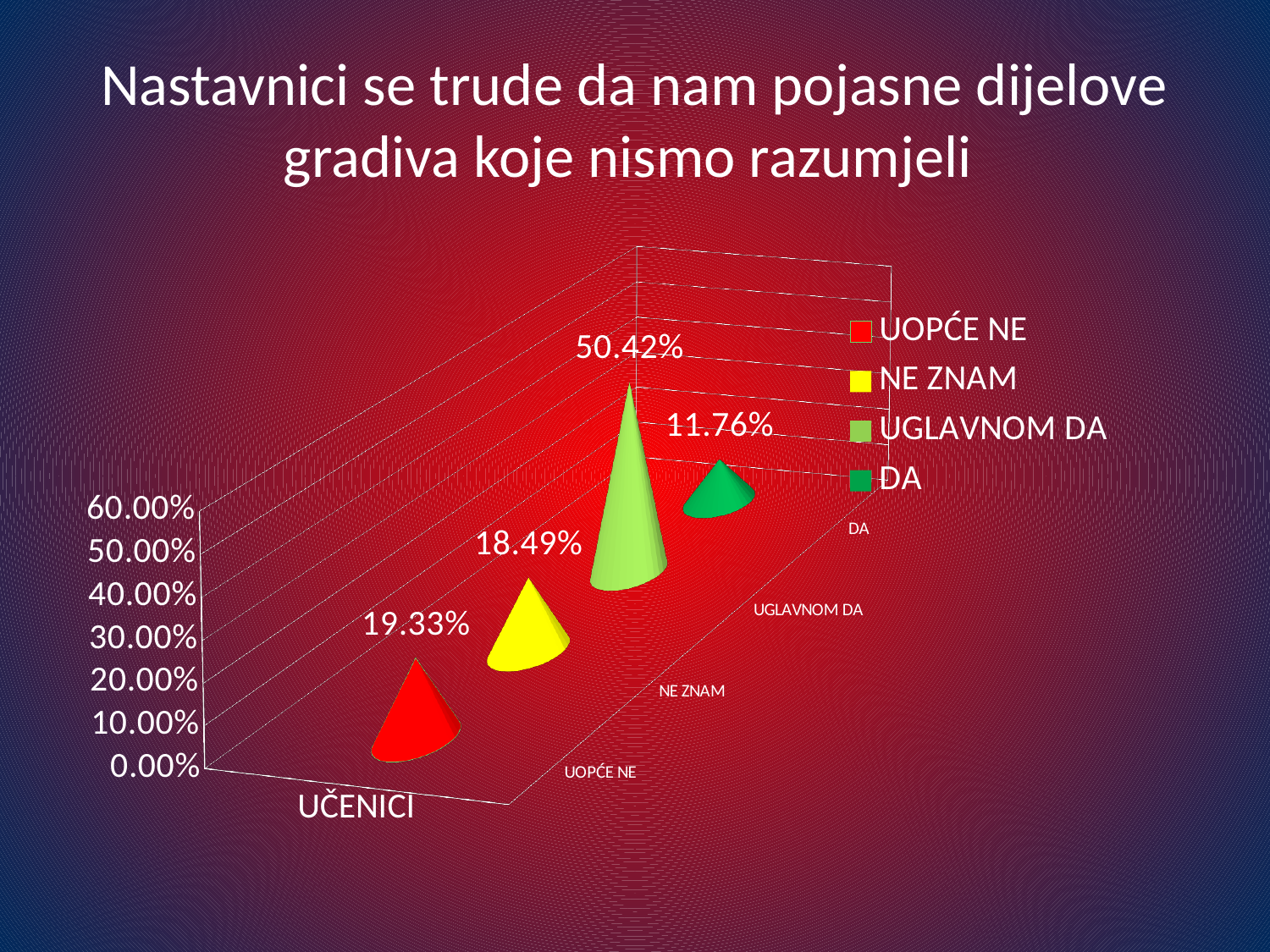
What is the value for DA? 11.76% How many series does the legend list? 4 What colour represents UGLAVNOM DA in the legend? Light green Which series has the lowest value? DA What is the difference between the values for UGLAVNOM DA and DA? 38.66% What is the difference between the values for UOPĆE NE and NE ZNAM? 0.84% What is the title of the chart? Nastavnici se trude da nam pojasne dijelove gradiva koje nismo razumjeli Which is larger, the value for UGLAVNOM DA or the value for UOPĆE NE? UGLAVNOM DA What is the value for UGLAVNOM DA? 50.42% Which series has the highest value? UGLAVNOM DA What is the value for UOPĆE NE? 19.33% What is the value for NE ZNAM? 18.49%